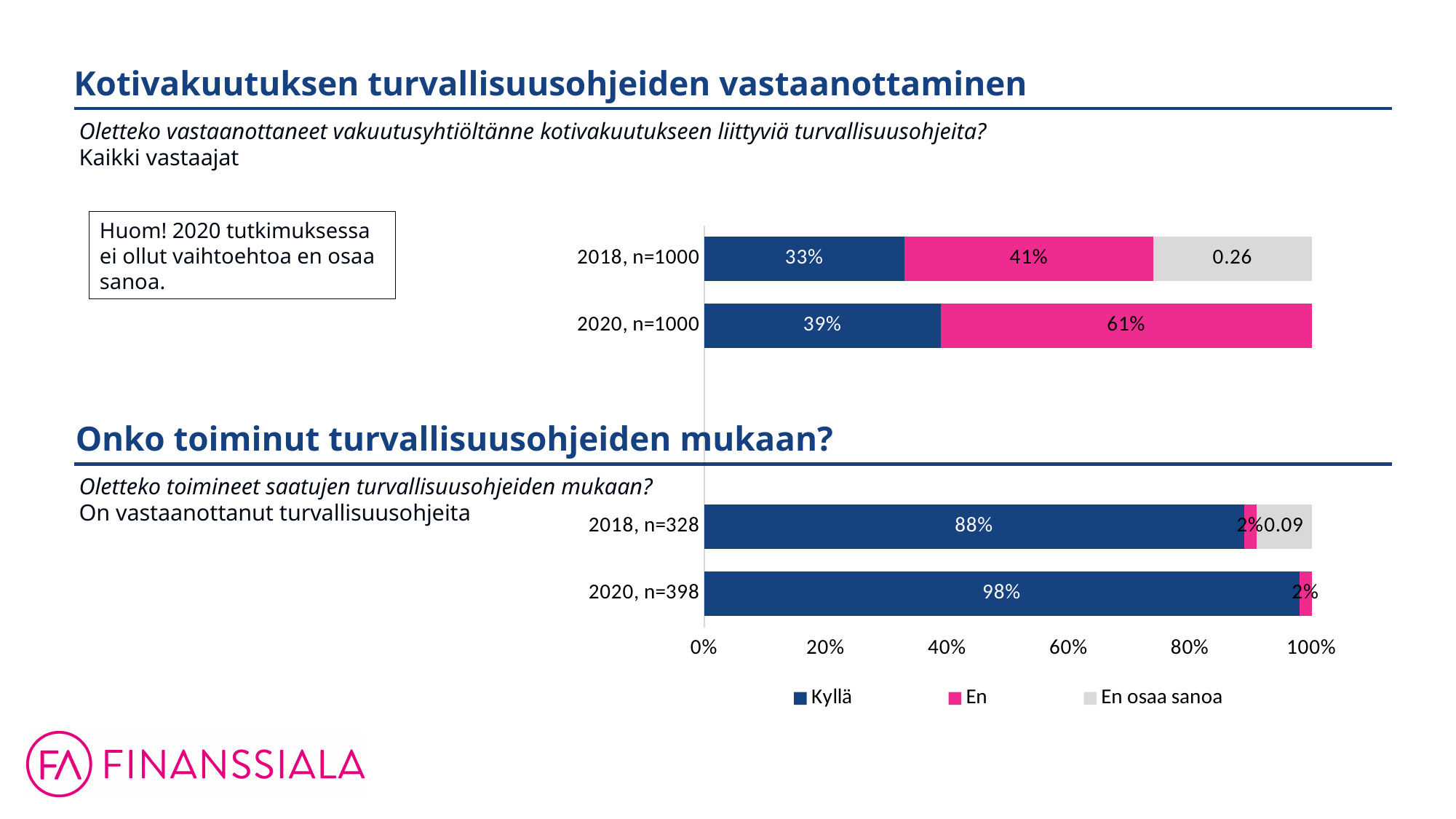
What kind of chart is used on this slide? Stacked bar chart In the chart 'Kotivakuutuksen turvallisuusohjeiden vastaanottaminen', for 2018, n=1000, which is larger: Kyllä or En? En In the chart 'Onko toiminut turvallisuusohjeiden mukaan?', what is the difference between the Kyllä values for 2020 and 2018? 10 percentage points In the chart 'Onko toiminut turvallisuusohjeiden mukaan?', what is the Kyllä value for 2020, n=398? 98% In the chart 'Kotivakuutuksen turvallisuusohjeiden vastaanottaminen', what is the En osaa sanoa value for 2018, n=1000? 0.26 In the chart 'Onko toiminut turvallisuusohjeiden mukaan?', what is the En osaa sanoa value for 2018, n=328? 0.09 How many series does the legend list? 3 In the chart 'Kotivakuutuksen turvallisuusohjeiden vastaanottaminen', what is the Kyllä value for 2018, n=1000? 33% In the chart 'Onko toiminut turvallisuusohjeiden mukaan?', what is the En value for 2018, n=328? 2% In the chart 'Kotivakuutuksen turvallisuusohjeiden vastaanottaminen', what is the En value for 2020, n=1000? 61% In the chart 'Kotivakuutuksen turvallisuusohjeiden vastaanottaminen', by how many percentage points did the Kyllä share increase from 2018 to 2020? 6 percentage points What colour represents the En series in the legend? Pink